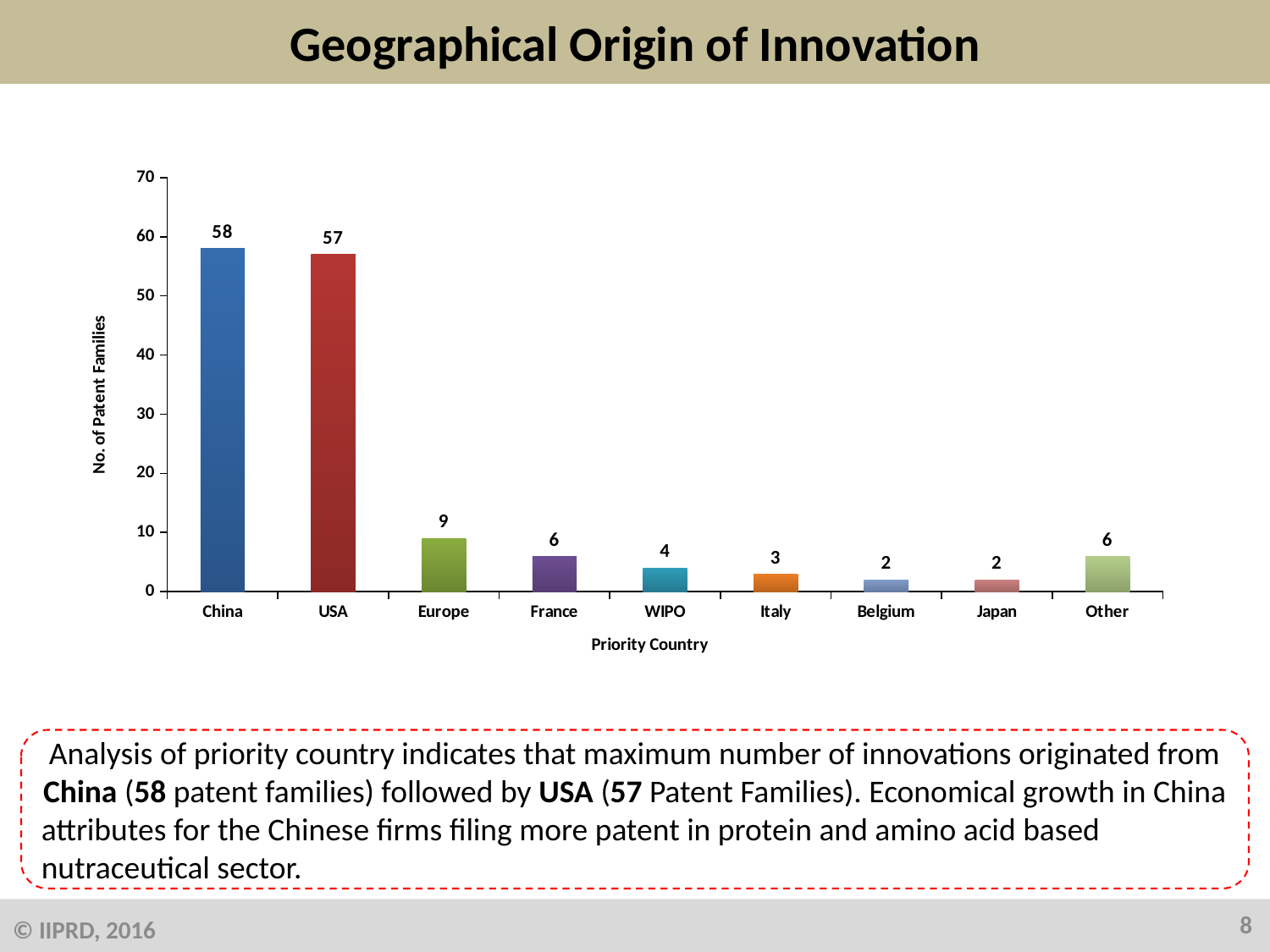
How many priority country categories are shown on the x axis? 9 Which priority country has the highest number of patent families? China What is the number of patent families for WIPO? 4 Which has more patent families, France or WIPO? France What is the label of the y axis? No. of Patent Families What is the difference in patent families between China and USA? 1 What is the number of patent families for China? 58 What is the label of the x axis? Priority Country What is the number of patent families for Europe? 9 Which priority countries have the lowest number of patent families? Belgium and Japan What kind of chart is shown on the slide? Bar chart What is the difference in patent families between Europe and Italy? 6